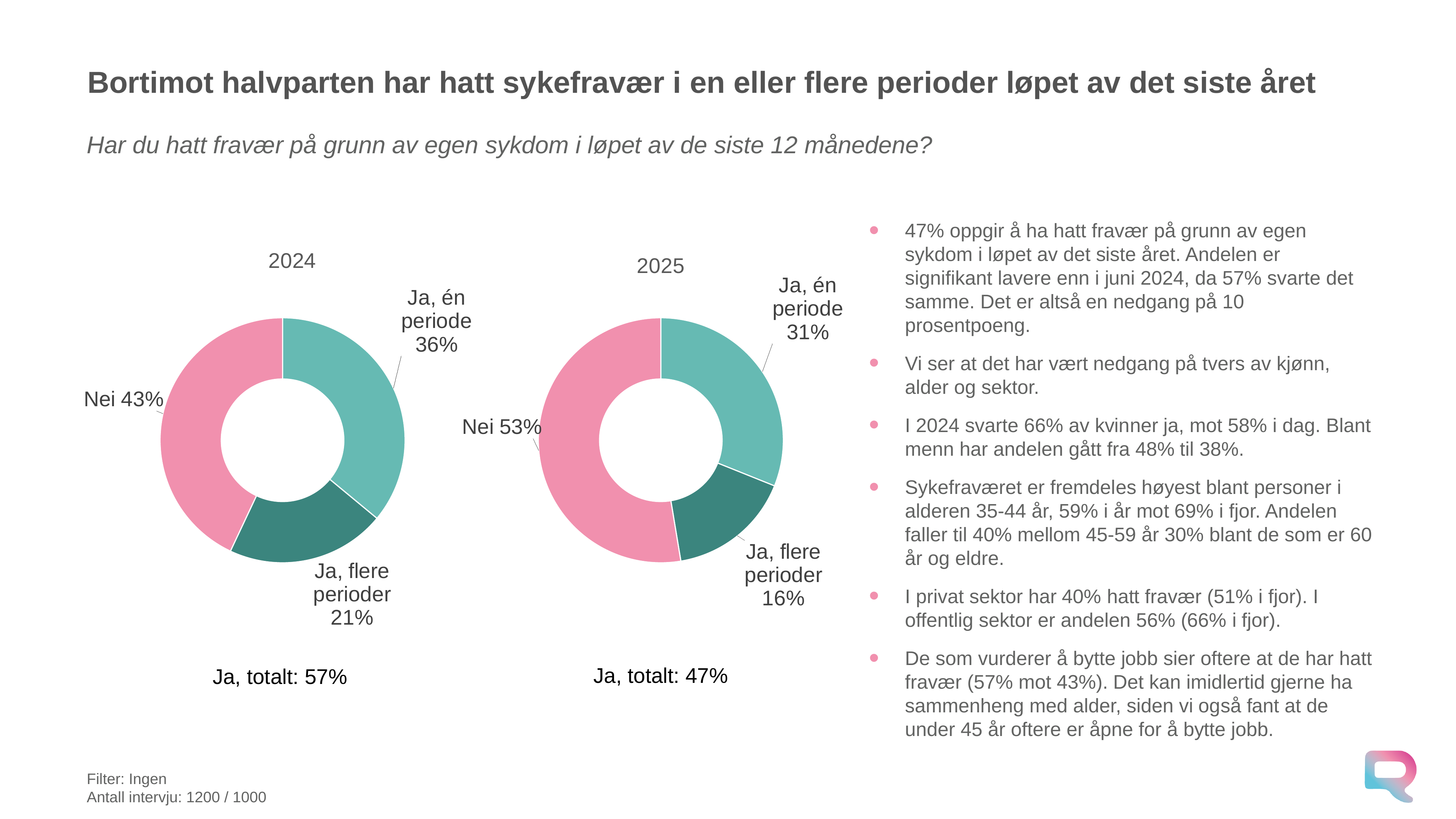
What is the difference between "Ja, én periode" and "Ja, flere perioder" in the 2024 chart? 15 percentage points In the 2025 chart, which category has the smallest share? Ja, flere perioder In the 2024 chart, what share of respondents answered "Nei"? 43% In the 2025 chart, what share of respondents answered "Ja, flere perioder"? 16% In the 2025 chart, what share of respondents answered "Ja, én periode"? 31% What colour is the "Nei" segment in both charts? Pink Which is larger: "Ja, én periode" in the 2024 chart or "Ja, én periode" in the 2025 chart? 2024 What is the difference between the "Nei" share in the 2025 chart and the "Nei" share in the 2024 chart? 10 percentage points What is the total "Ja" share shown below the 2024 chart? 57% What kind of chart is the 2025 chart? Doughnut chart How many categories does the 2024 chart show? 3 In the 2024 chart, which category has the largest share? Nei